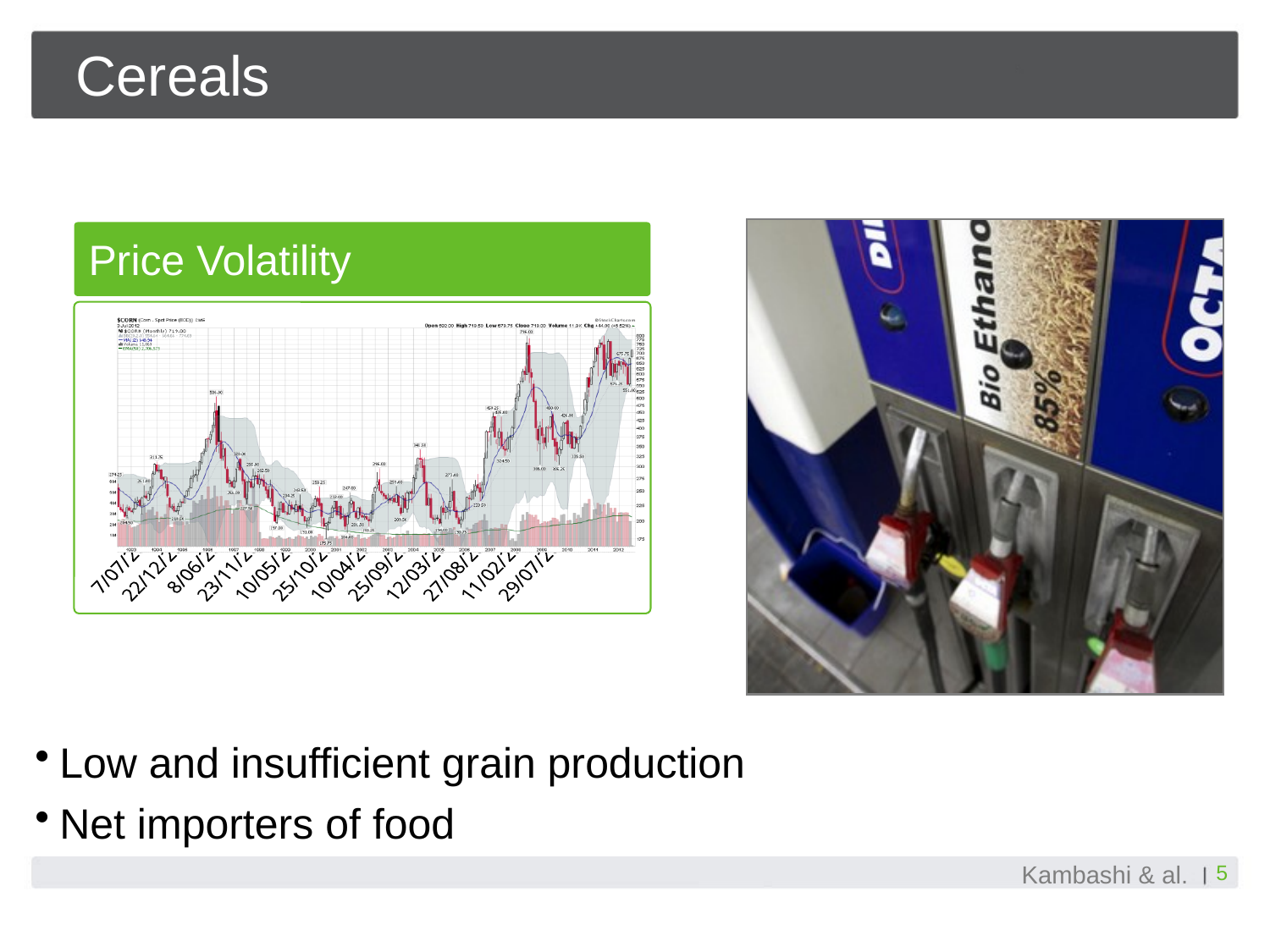
What is the title shown above the chart on the slide? Price Volatility How many date labels are printed along the x axis of the 'Price Volatility' chart? 12 Which commodity's price does the chart track, according to its header? Corn Overall, do the prices in the 'Price Volatility' chart rise or fall from left to right along the x axis? Rise Is the highest peak in the 'Price Volatility' chart greater or less than 700 on the price axis? greater What kind of chart is shown under the 'Price Volatility' heading? A candlestick price chart